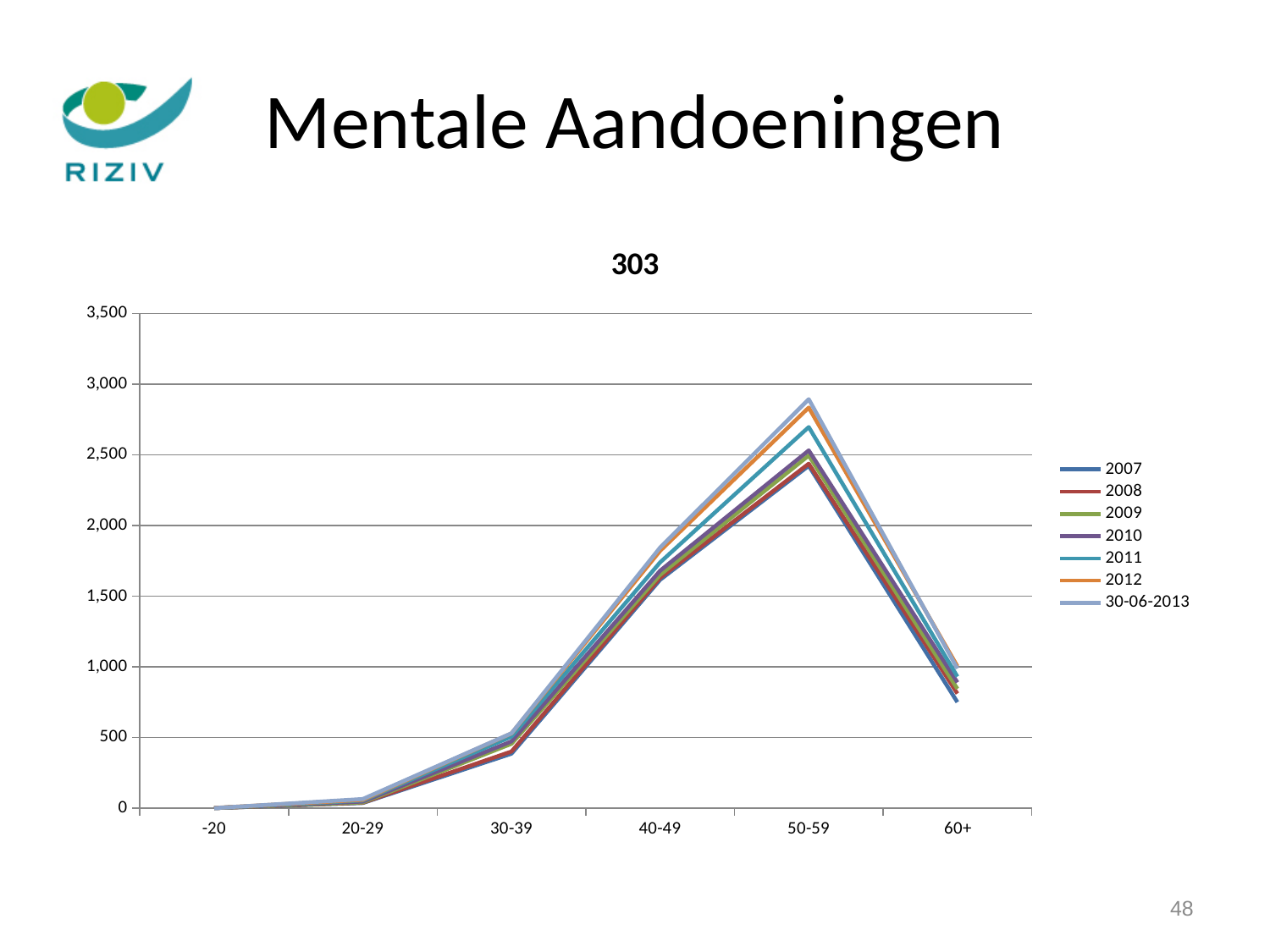
In the 50-59 category, which series has the larger value, 2007 or 30-06-2013? 30-06-2013 What kind of chart is shown on the slide? line chart For which age category does the 2007 series have its lowest value? -20 What is the title of the chart? 303 Do the values of the 2012 series rise or fall from the 50-59 category to the 60+ category? fall Is the value for 30-06-2013 in the 40-49 category greater or less than 1,500? greater How many series does the legend of the chart list? 7 Which legend entry is listed last in the chart's legend? 30-06-2013 How many age categories are shown on the x axis of the chart? 6 Is the value for 2007 in the 60+ category greater or less than 1,000? less Is the value for 30-06-2013 in the 50-59 category greater or less than 2,500? greater For which age category does the 30-06-2013 series reach its highest value? 50-59